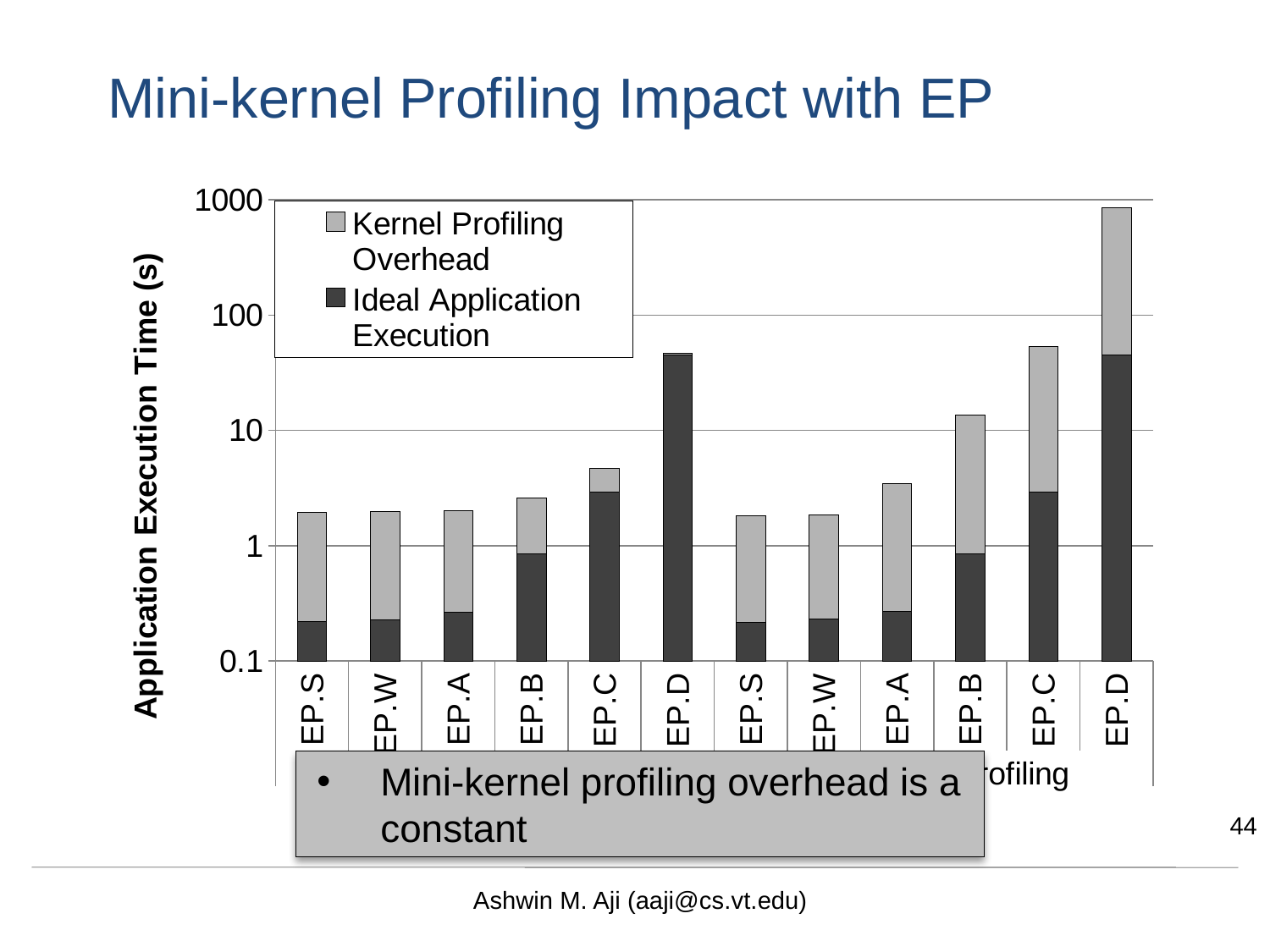
How many series does the legend list? 2 What is the label of the y axis? Application Execution Time (s) Which bar has the highest total application execution time? the rightmost EP.D bar Is the Ideal Application Execution value for the first EP.B bar (fourth from the left) greater or less than 1? less What kind of chart is shown on the slide? stacked bar chart How many bars are plotted in the chart? 12 Is the Ideal Application Execution value for the first EP.C bar (fifth from the left) greater or less than 1? greater What are the two series named in the legend? Kernel Profiling Overhead; Ideal Application Execution Is the total value of the first EP.D bar (sixth from the left) greater or less than 100? less Within the first group of six bars (EP.S through EP.D), do the total values rise or fall from left to right? rise Which has the larger total: the first EP.D bar (sixth from the left) or the second EP.D bar (rightmost)? the second EP.D bar (rightmost)